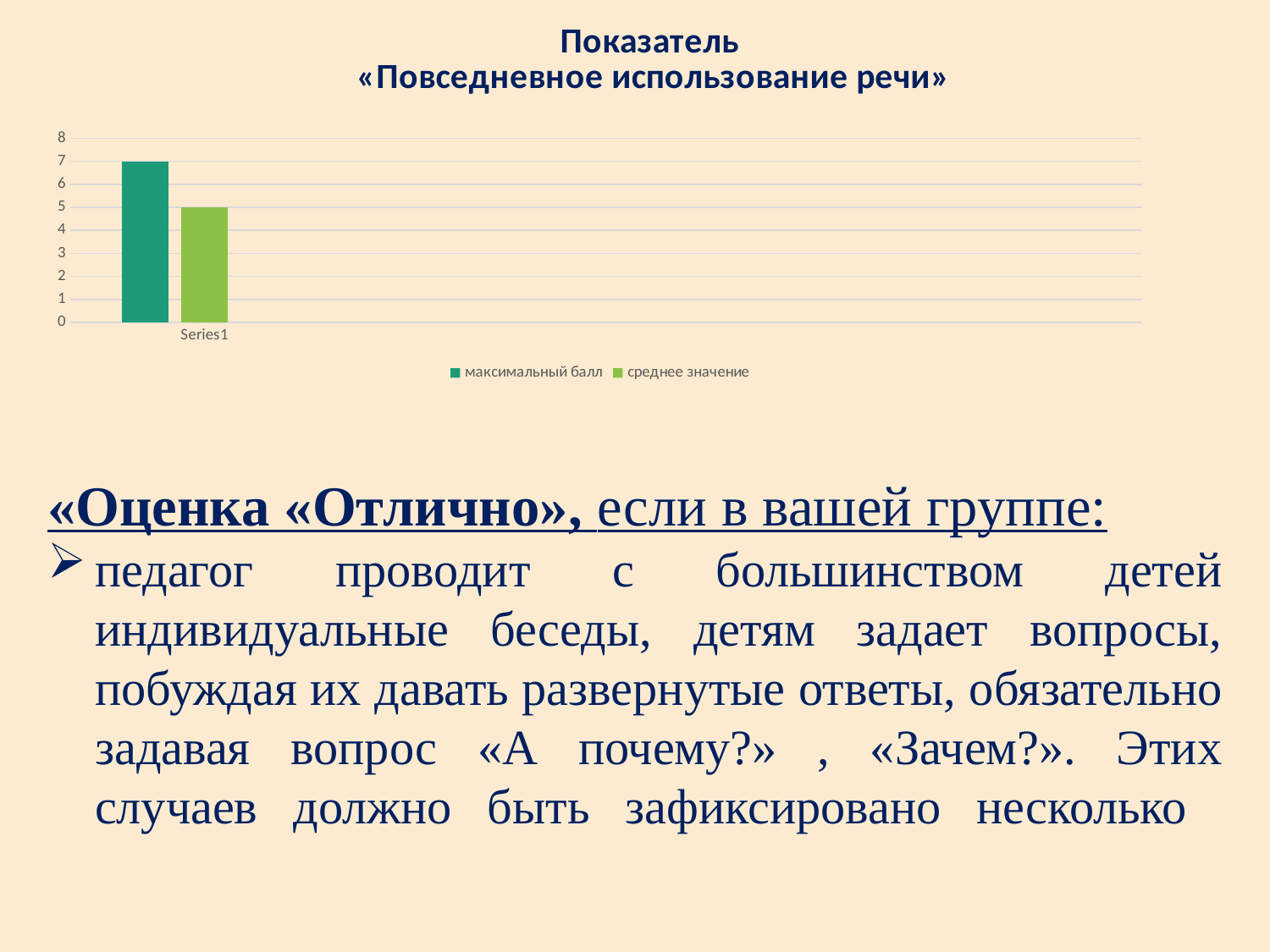
What is the value of the 'максимальный балл' bar? 7 Is the value for 'максимальный балл' greater or less than 4? greater What is the difference between the 'максимальный балл' bar and the 'среднее значение' bar? 2 Which series has the lowest bar in the chart? среднее значение How many categories are shown on the x axis of the chart? 1 What is the highest value shown on the chart's vertical axis? 8 Which series has the higher bar, 'максимальный балл' or 'среднее значение'? максимальный балл How many series does the chart legend list? 2 What is the value of the 'среднее значение' bar? 5 What are the two series named in the chart legend? максимальный балл, среднее значение What kind of chart is shown on the slide? bar chart Is the value for 'среднее значение' greater or less than 6? less